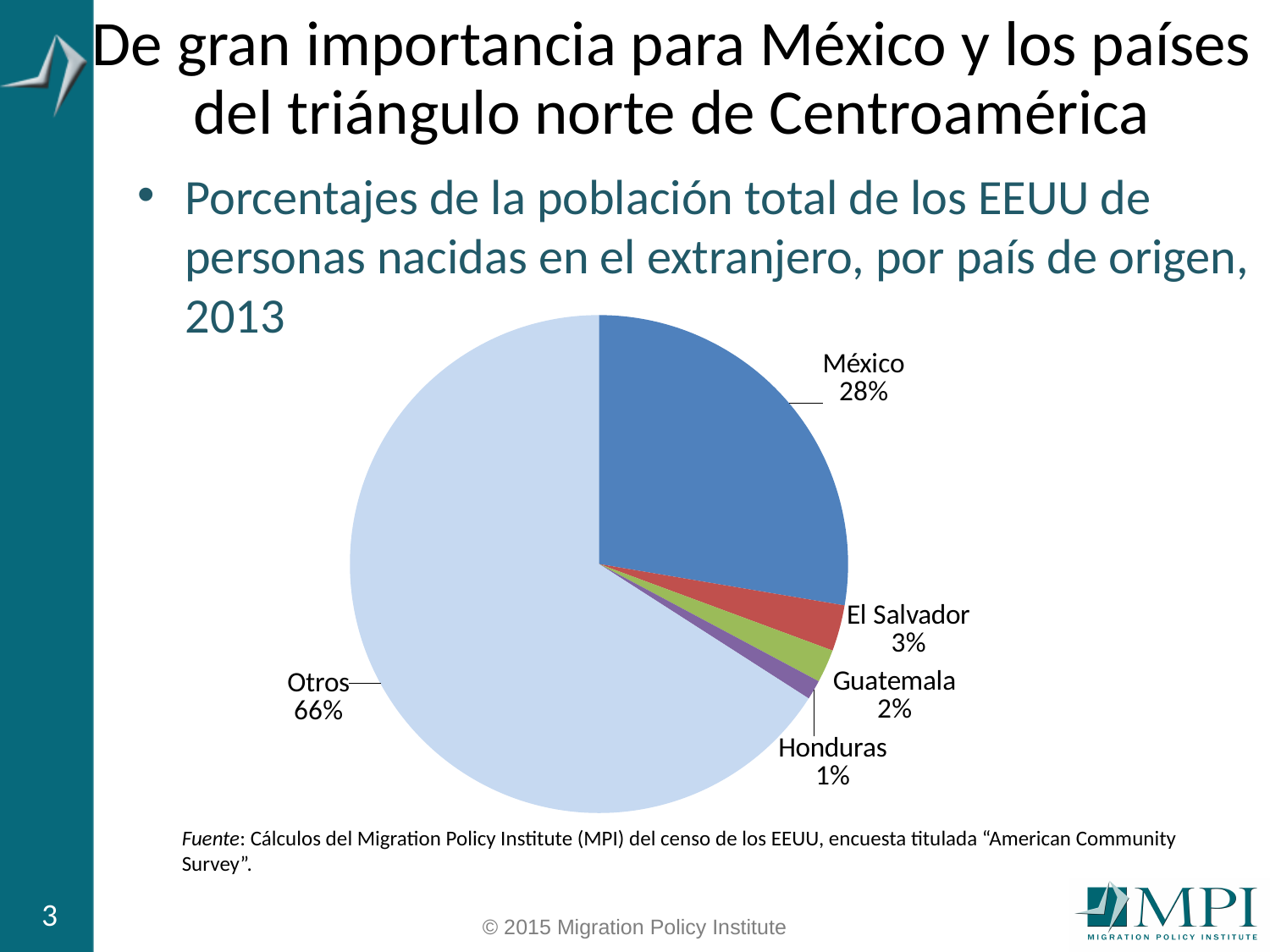
What percentage of the pie is labelled for Otros? 66% What kind of chart is shown on the slide? pie chart What percentage of the pie is labelled for México? 28% Which slice is larger, El Salvador or Guatemala? El Salvador Which slice of the pie is the largest? Otros What percentage of the pie is labelled for El Salvador? 3% Which slice of the pie is the smallest? Honduras What is the difference in percentage points between the Otros slice and the México slice? 38 What percentage of the pie is labelled for Guatemala? 2% What percentage of the pie is labelled for Honduras? 1% What is the combined share of El Salvador, Guatemala and Honduras? 6% How many slices does the pie chart have? 5